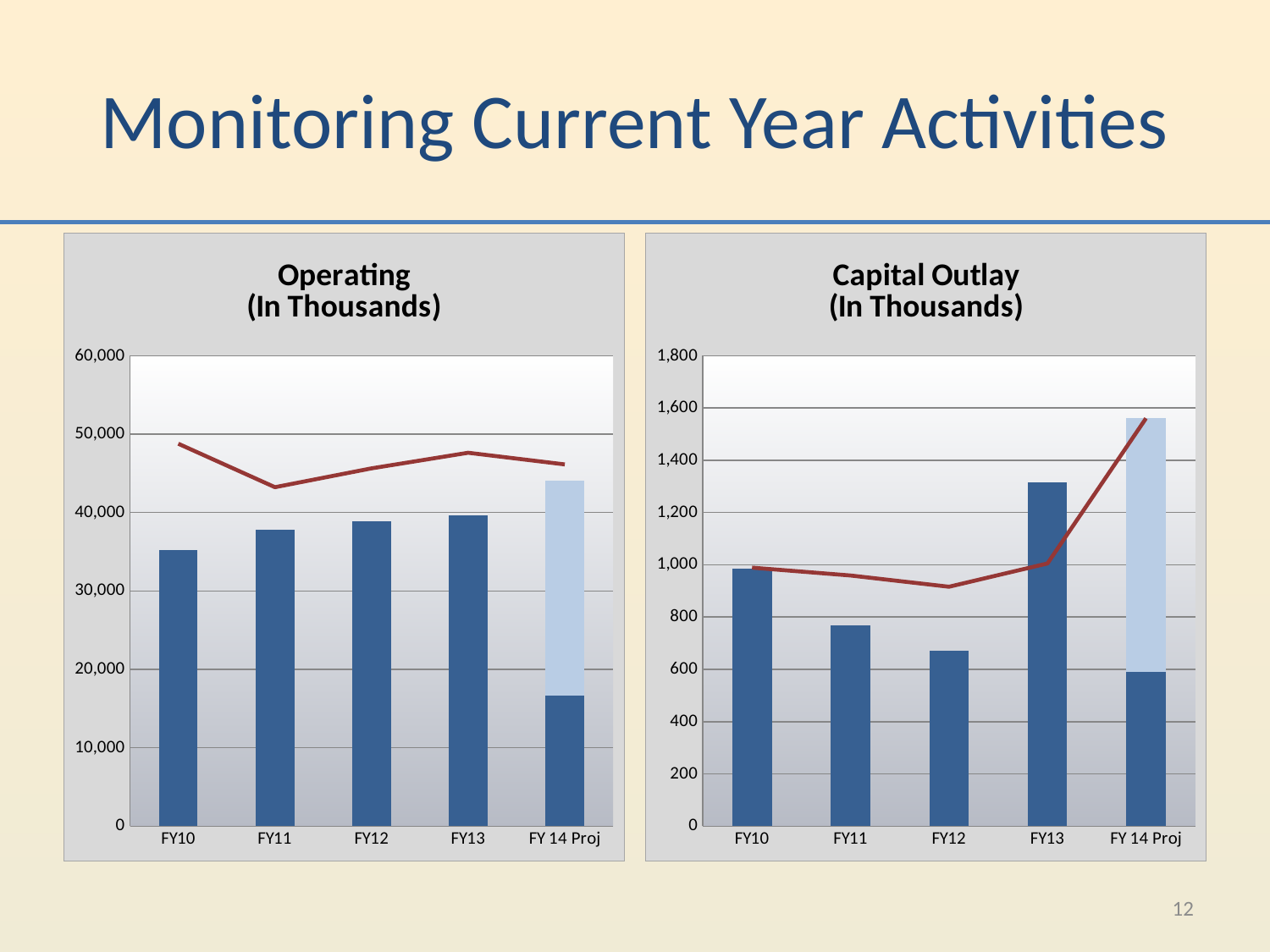
In the Operating (In Thousands) chart, is the bar for FY10 greater or less than 30,000? greater In the Capital Outlay (In Thousands) chart, does the red line rise or fall between FY13 and FY 14 Proj? rise What is the title of the chart on the right side of the slide? Capital Outlay (In Thousands) In the Capital Outlay (In Thousands) chart, which fiscal year from FY10 to FY13 has the highest bar? FY13 What kind of chart is the Operating (In Thousands) chart? bar chart with a line In the Capital Outlay (In Thousands) chart, is the bar for FY11 larger or smaller than the bar for FY12? larger In the Operating (In Thousands) chart, is the dark blue bar for FY 14 Proj greater or less than 20,000? less In the Capital Outlay (In Thousands) chart, which fiscal year from FY10 to FY13 has the lowest bar? FY12 In the Capital Outlay (In Thousands) chart, is the bar for FY13 greater or less than 1,200? greater How many fiscal year categories are shown on the x axis of the Capital Outlay (In Thousands) chart? 5 In the Operating (In Thousands) chart, do the dark blue bars rise or fall from FY10 to FY13? rise In the Operating (In Thousands) chart, which of the dark blue bars from FY10 to FY13 is the lowest? FY10